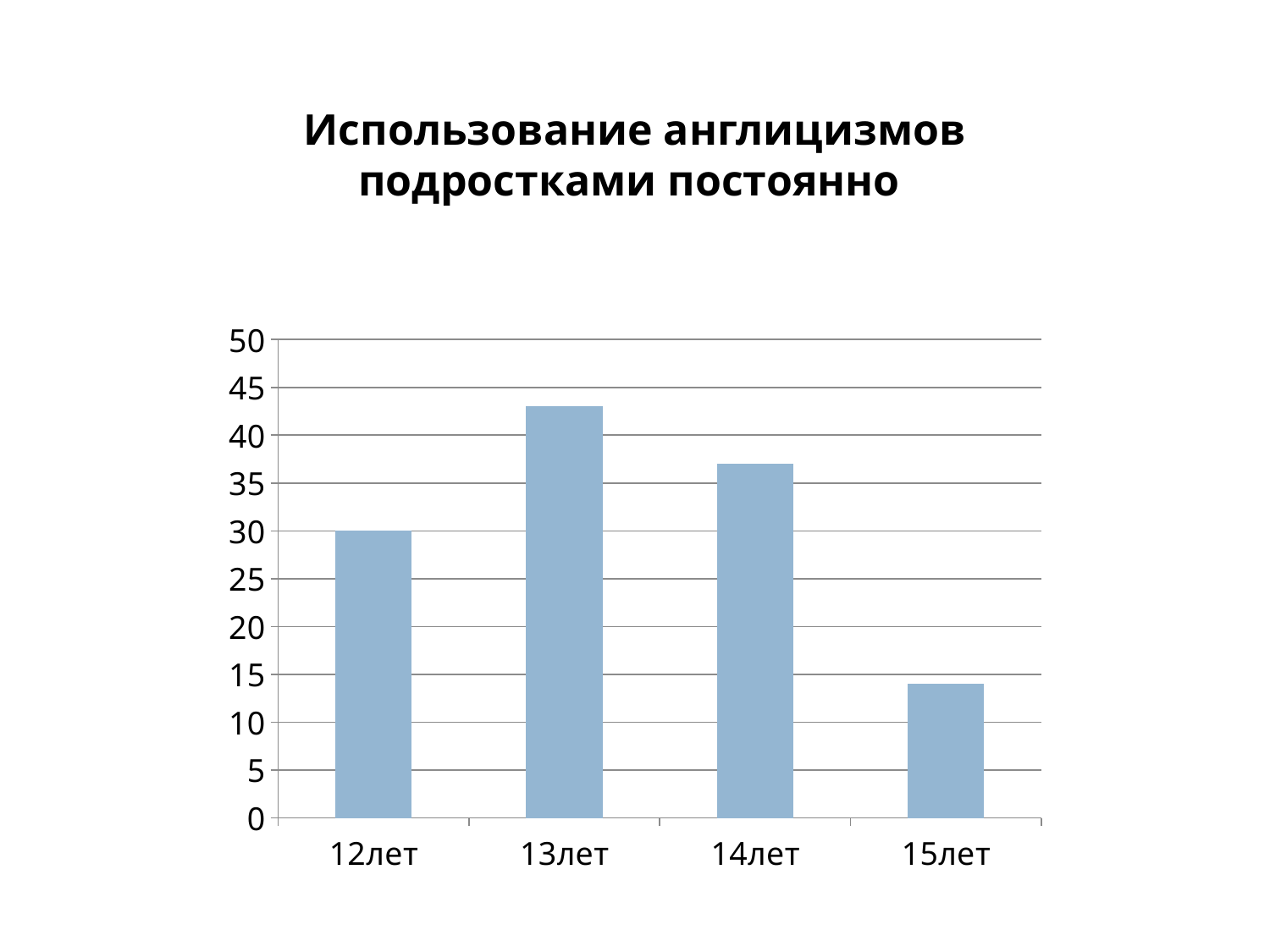
Which is larger, the value for 12лет or the value for 15лет? 12лет What type of chart is shown on the slide? bar chart Which is larger, the value for 13лет or the value for 14лет? 13лет Do the values rise or fall from 13лет to 15лет along the x axis? fall Which age group has the highest bar? 13лет What is the title of the chart? Использование англицизмов подростками постоянно Is the value for 14лет greater or less than 35? greater Is the value for 15лет greater or less than 15? less Is the value for 13лет greater or less than 40? greater Which age group has the lowest bar? 15лет What is the value for 12лет? 30 How many age categories are shown on the x axis? 4